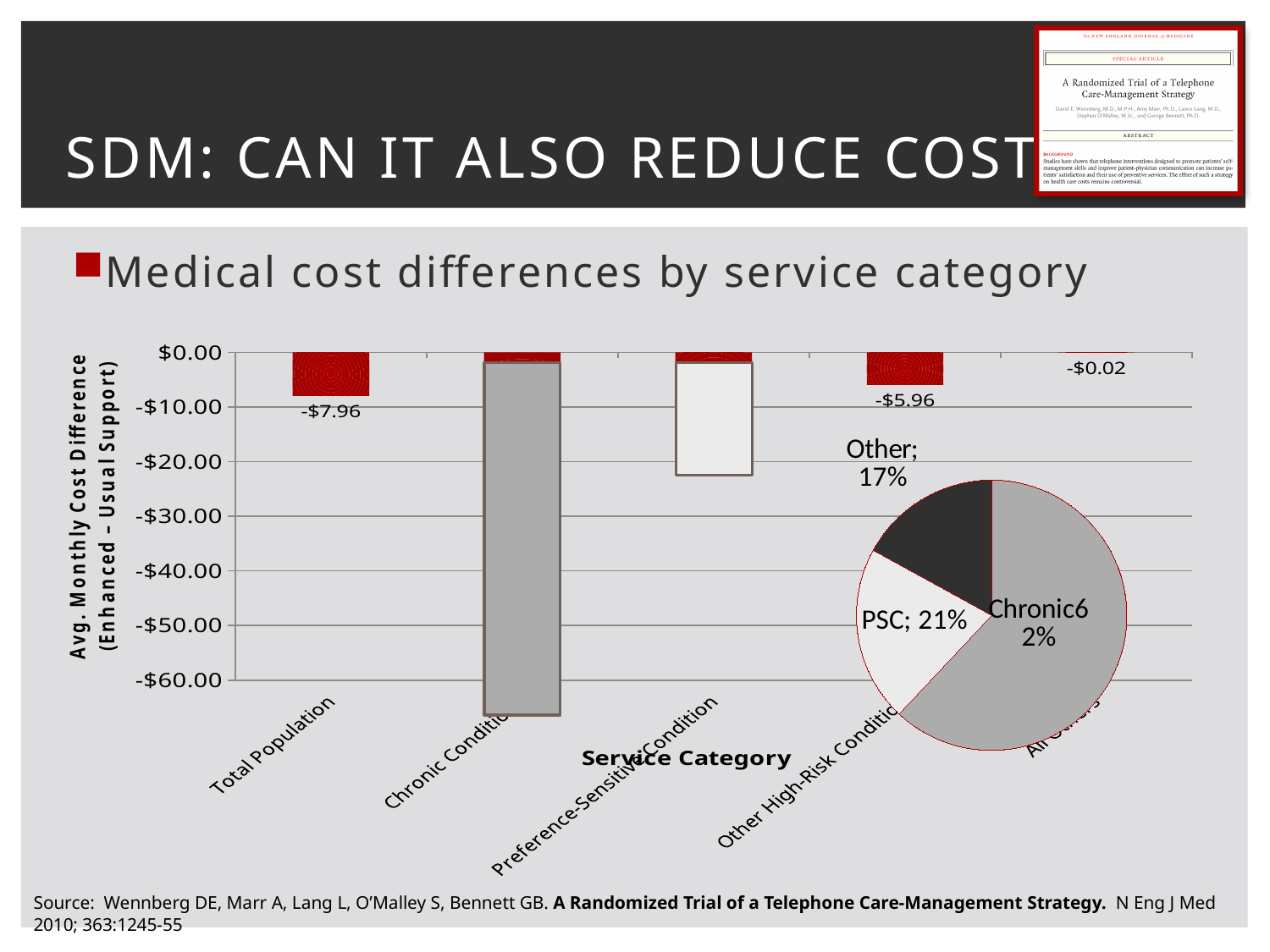
In the pie chart, what share does Other have? 17% What kind of chart is the chart on the left showing cost differences by service category? bar chart How many service categories are shown in the bar chart? 5 In the bar chart, what is the average monthly cost difference for All Others? -$0.02 In the bar chart, what is the average monthly cost difference for Total Population? -$7.96 In the bar chart, which service category has the lowest (most negative) cost difference? Chronic Condition In the bar chart, what is the average monthly cost difference for Other High-Risk Condition? -$5.96 In the pie chart, what share does PSC have? 21% In the bar chart, is the value for Preference-Sensitive Condition greater or less than -$10.00? less In the bar chart, is the value for Chronic Condition greater or less than -$60.00? less In the pie chart, which slice is the largest? Chronic In the bar chart, what is the difference between the values for Total Population and Other High-Risk Condition? $2.00